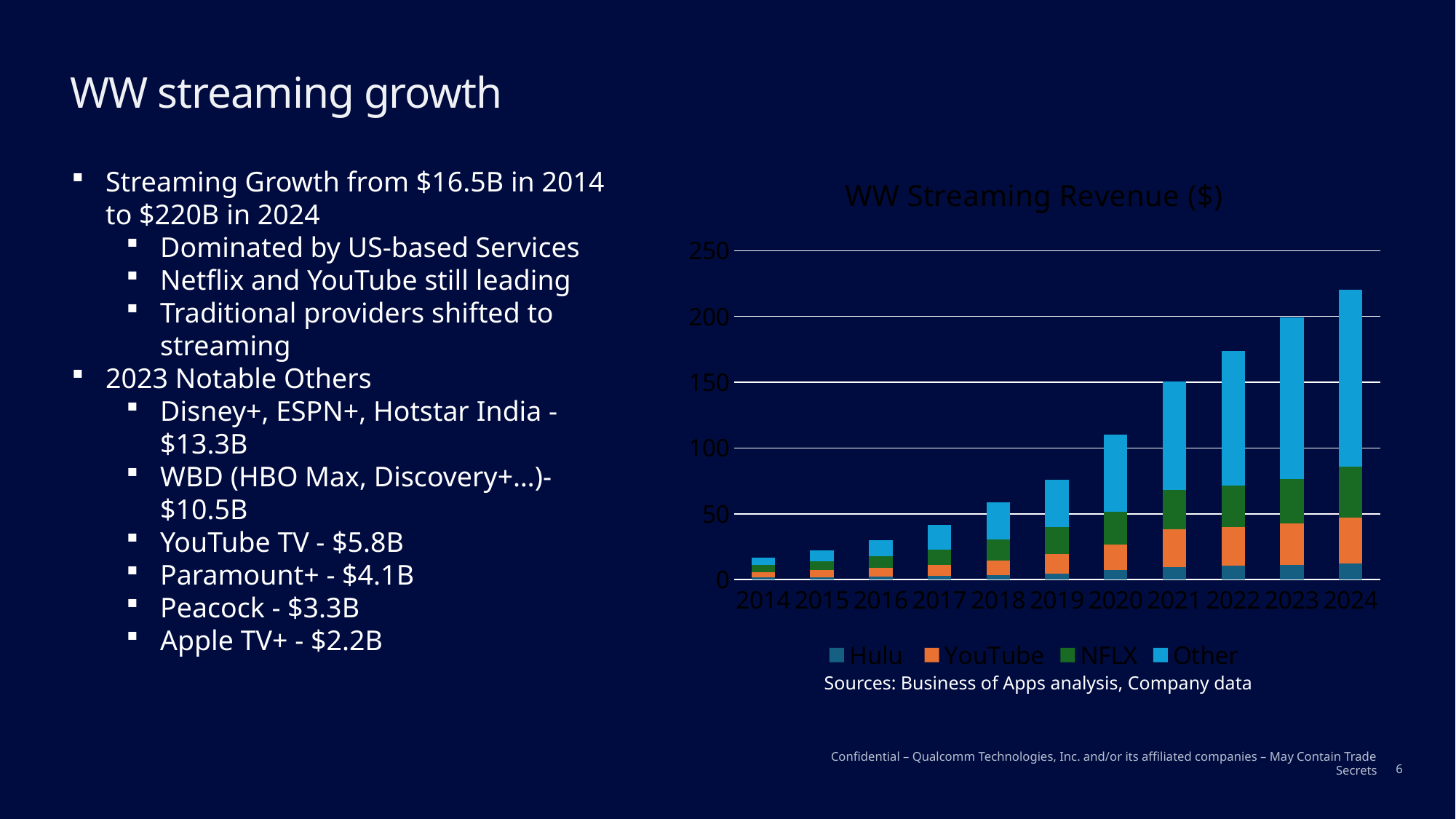
How many series does the chart legend list? 4 Which year has the larger total bar, 2019 or 2022? 2022 Is the total value for 2020 greater or less than 100? greater How many years are shown on the x axis of the chart? 11 Is the total value for 2024 greater or less than 200? greater Which series are listed in the chart legend? Hulu, YouTube, NFLX, Other Which year has the lowest total streaming revenue in the chart? 2014 Is the total value for 2017 greater or less than 50? less Which year has the highest total streaming revenue in the chart? 2024 What type of chart is shown on the slide? Stacked bar chart What is the title of the chart? WW Streaming Revenue ($) Do the total bar heights rise or fall from 2014 to 2024? Rise